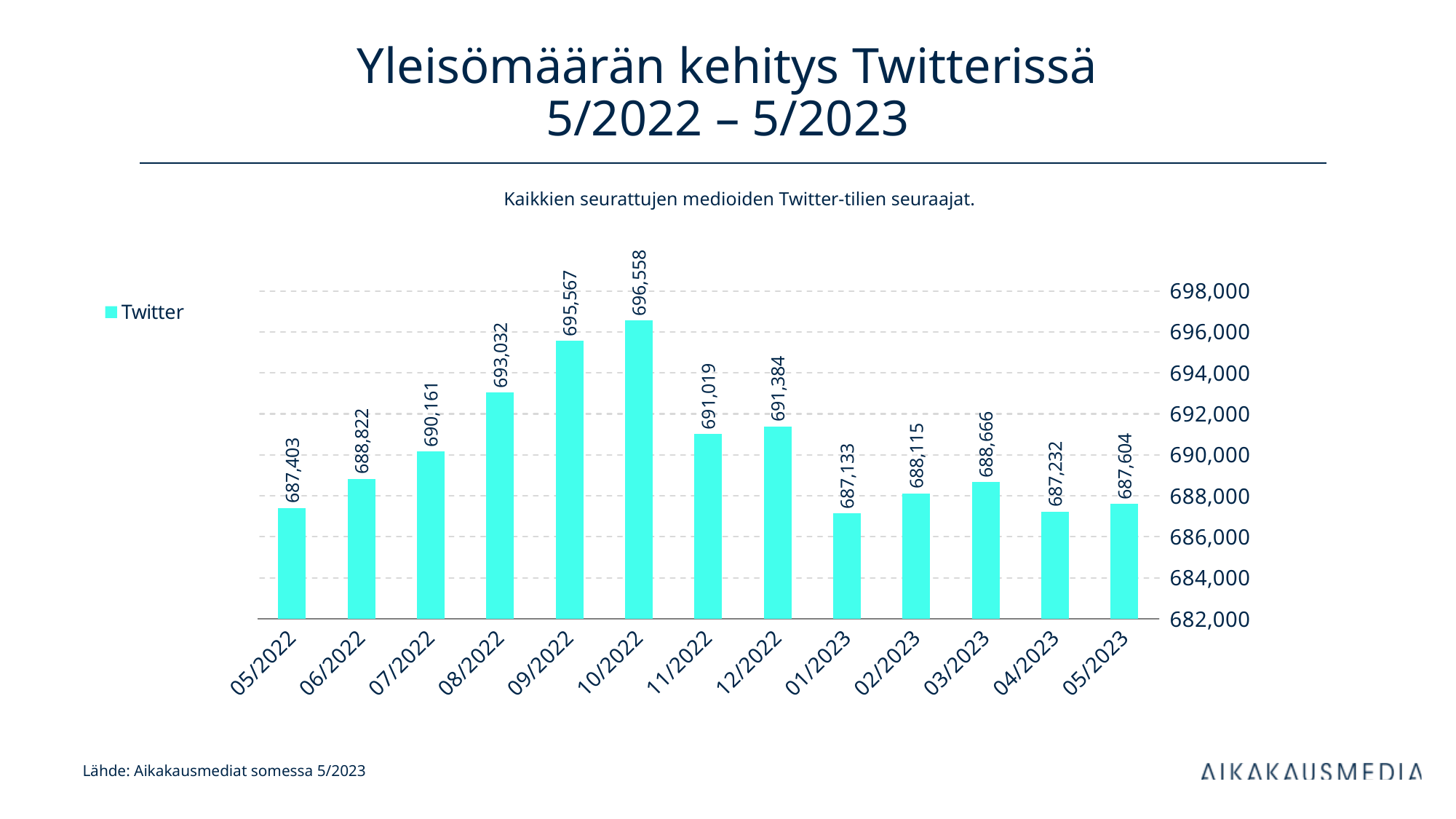
Which month has the lowest value? 01/2023 How many months are shown on the x axis? 13 Which is larger, the value for 12/2022 or the value for 11/2022? 12/2022 What is the difference between the values for 10/2022 and 05/2022? 9,155 What is the value for 02/2023? 688,115 What kind of chart is shown on the slide? Bar chart How many series does the legend list? 1 What is the difference between the values for 09/2022 and 08/2022? 2,535 What is the value for 05/2022? 687,403 What is the value for 10/2022? 696,558 Is the value for 08/2022 greater or less than 692,000? greater Which month has the highest value? 10/2022